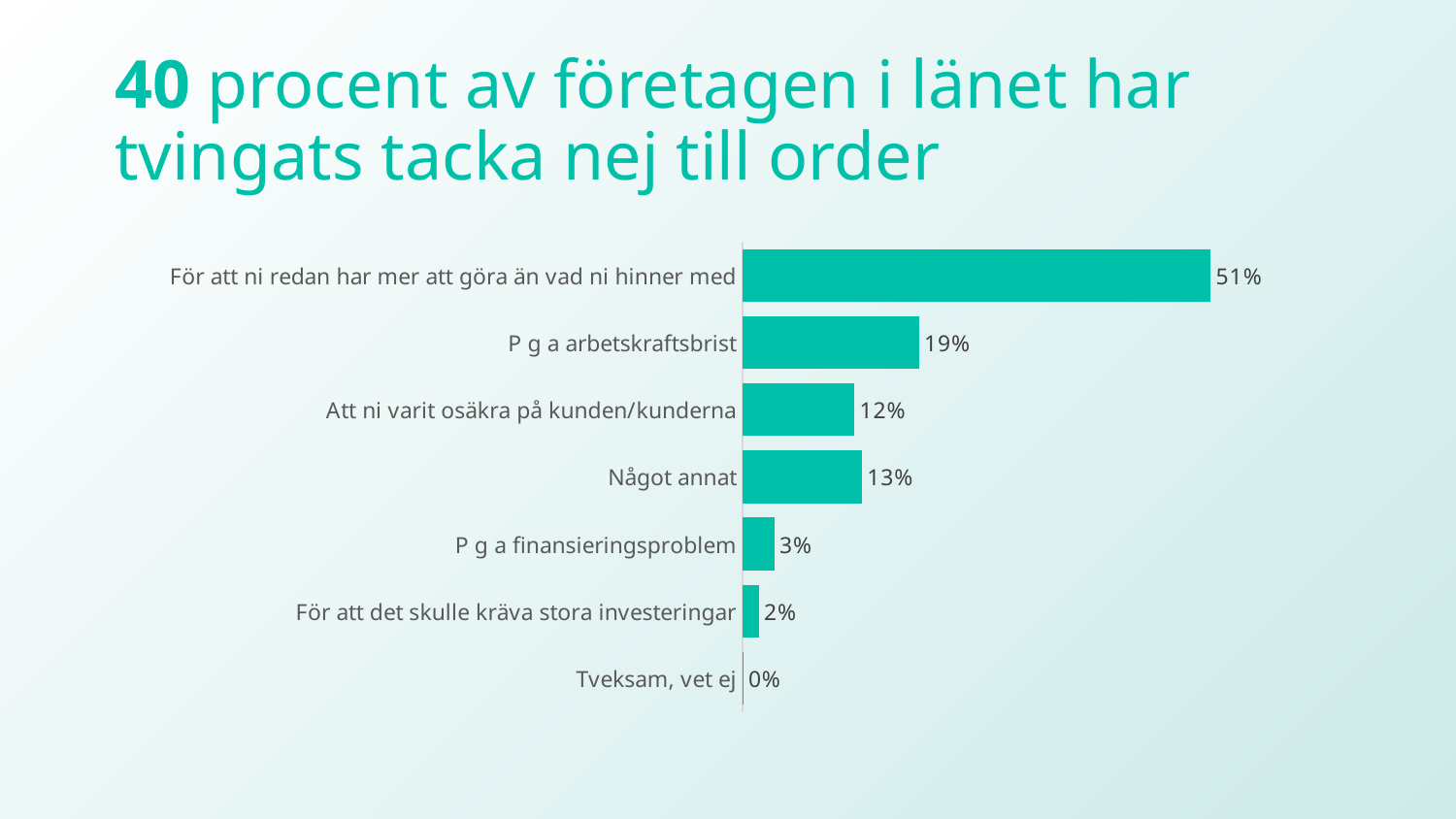
What is the value for "För att det skulle kräva stora investeringar"? 2% What is the difference between the values for "För att ni redan har mer att göra än vad ni hinner med" and "P g a arbetskraftsbrist"? 32% What is the value for "P g a arbetskraftsbrist"? 19% Which is larger, the value for "Något annat" or the value for "Att ni varit osäkra på kunden/kunderna"? Något annat What is the difference between the values for "P g a finansieringsproblem" and "För att det skulle kräva stora investeringar"? 1% How many categories are shown in the chart? 7 What kind of chart is shown on the slide? Bar chart What is the value for "Tveksam, vet ej"? 0% What is the title of the slide? 40 procent av företagen i länet har tvingats tacka nej till order What is the value for "Något annat"? 13% Which category has the highest value? För att ni redan har mer att göra än vad ni hinner med Which category has the lowest value? Tveksam, vet ej